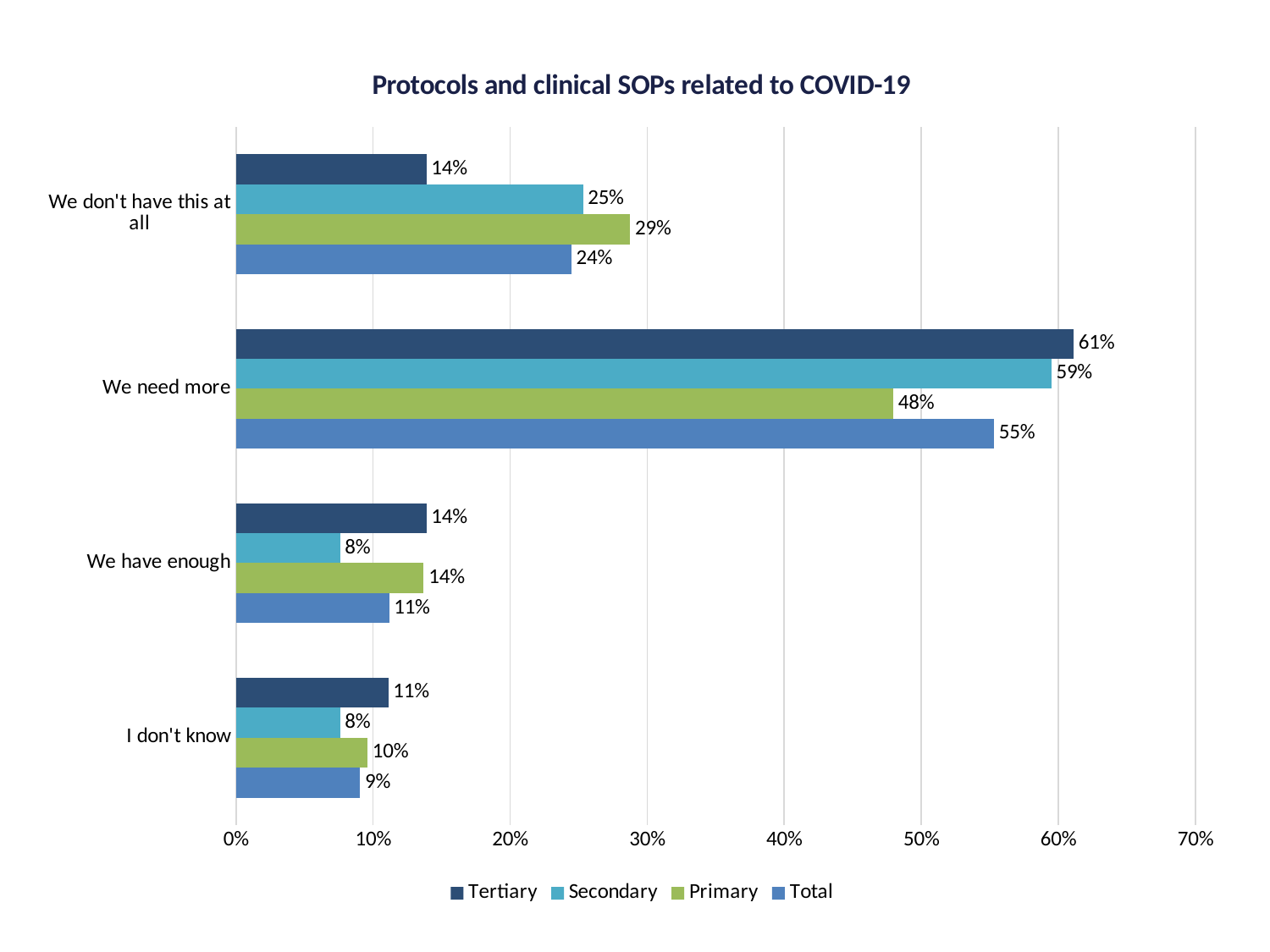
How many categories are shown on the y axis? 4 What is the difference between the Tertiary and Primary values for "We need more"? 13% What kind of chart is this? Bar chart Which category has the highest Tertiary value? We need more How many series does the legend list? 4 What is the Secondary value for "We have enough"? 8% Which category has the lowest Total value? I don't know Which is larger for "We don't have this at all": the Secondary value or the Tertiary value? Secondary What is the Tertiary value for "I don't know"? 11% What is the Total value for "We need more"? 55% What is the title of the chart? Protocols and clinical SOPs related to COVID-19 What is the Primary value for "We don't have this at all"? 29%